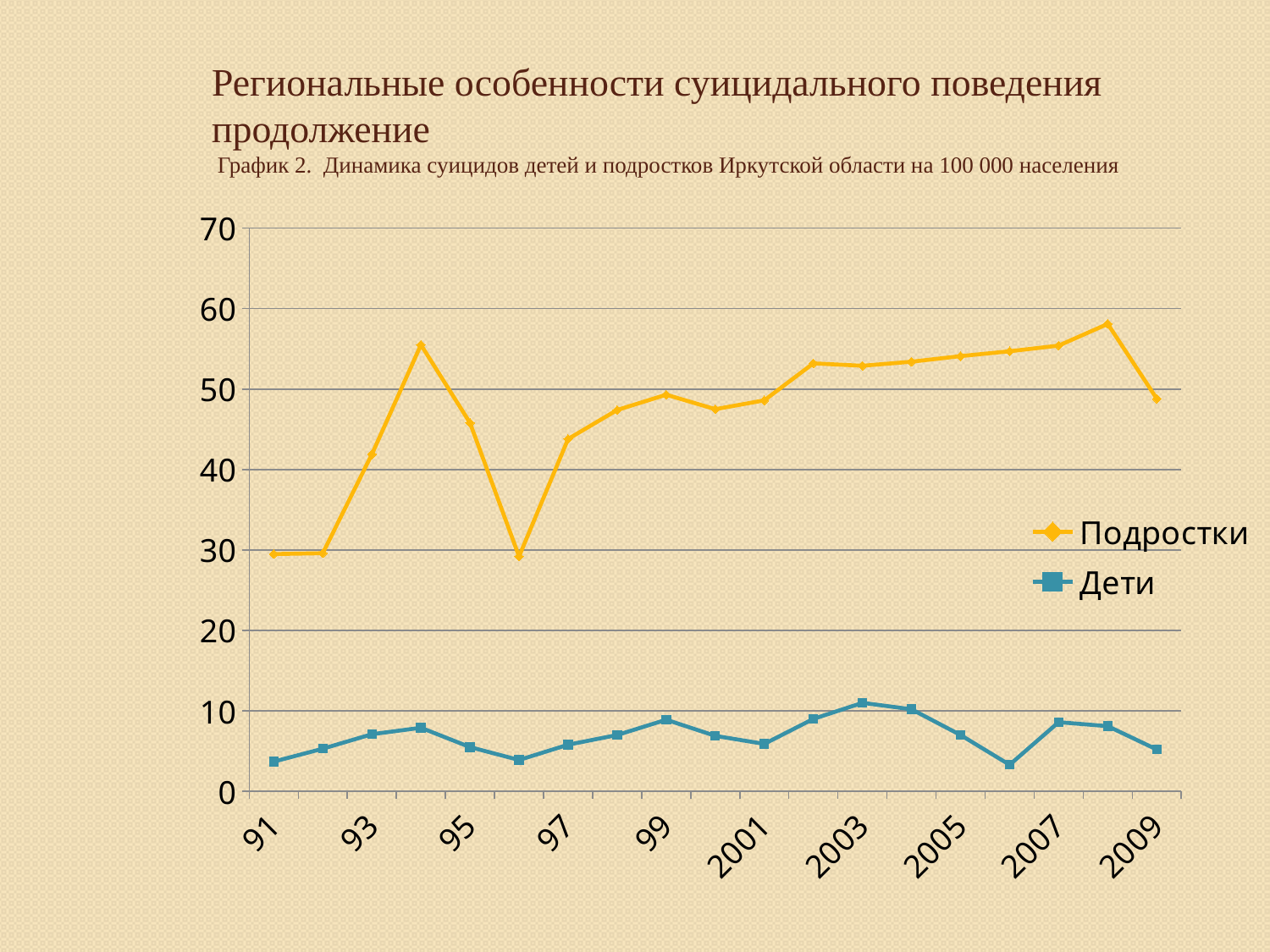
Does the Подростки line rise or fall from 2002 to 2008? rise What are the two series named in the legend? Подростки and Дети In which year does the Подростки series reach its highest value? 2008 Is the value for Дети in 2003 greater or less than 10? greater Which is larger for Подростки: the value in 94 or the value in 95? 94 How many series does the legend list? 2 Is the value for Подростки in 94 greater or less than 50? greater How many data points does each line have? 19 What kind of chart is shown on the slide? line chart In which year does the Дети series reach its highest value? 2003 Which series has higher values across all years, Подростки or Дети? Подростки